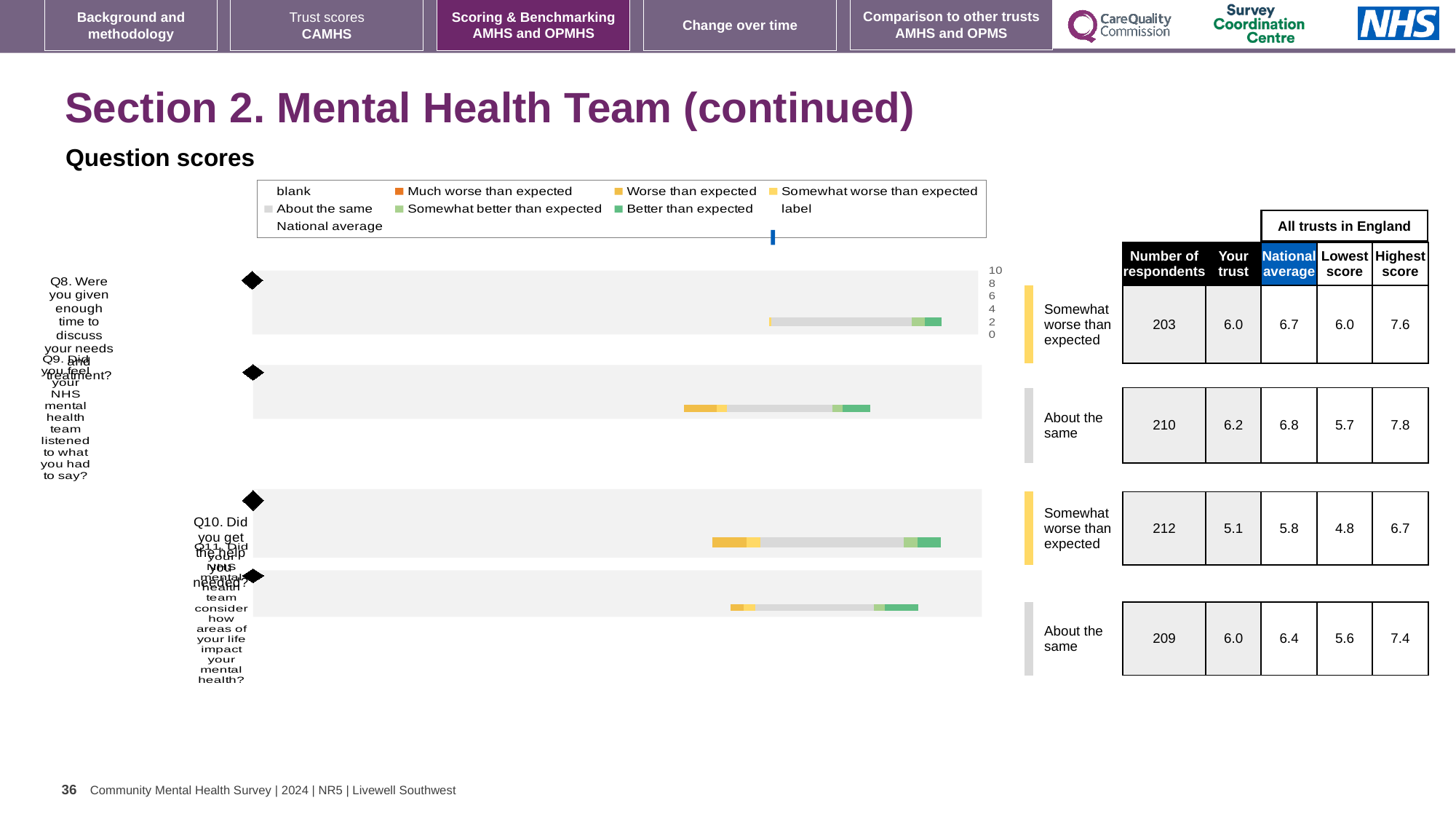
What is the difference between the Highest score and the Lowest score for Q9? 2.1 What is the Highest score listed for Q11? 7.4 Which question has the highest 'Your trust' score? Q9 How many respondents are listed for Q10? 212 What benchmark category is shown for Q10? Somewhat worse than expected How many entries does the legend of the Question scores chart list? 9 What is the 'Your trust' score for Q8 in the table beside the chart? 6.0 What kind of chart is shown under 'Question scores'? bar chart What is the National average score for Q9? 6.8 Which question has the lowest 'Your trust' score? Q10 How many questions (categories) are plotted in the Question scores chart? 4 For Q8, which is larger: the 'Your trust' score or the National average? National average